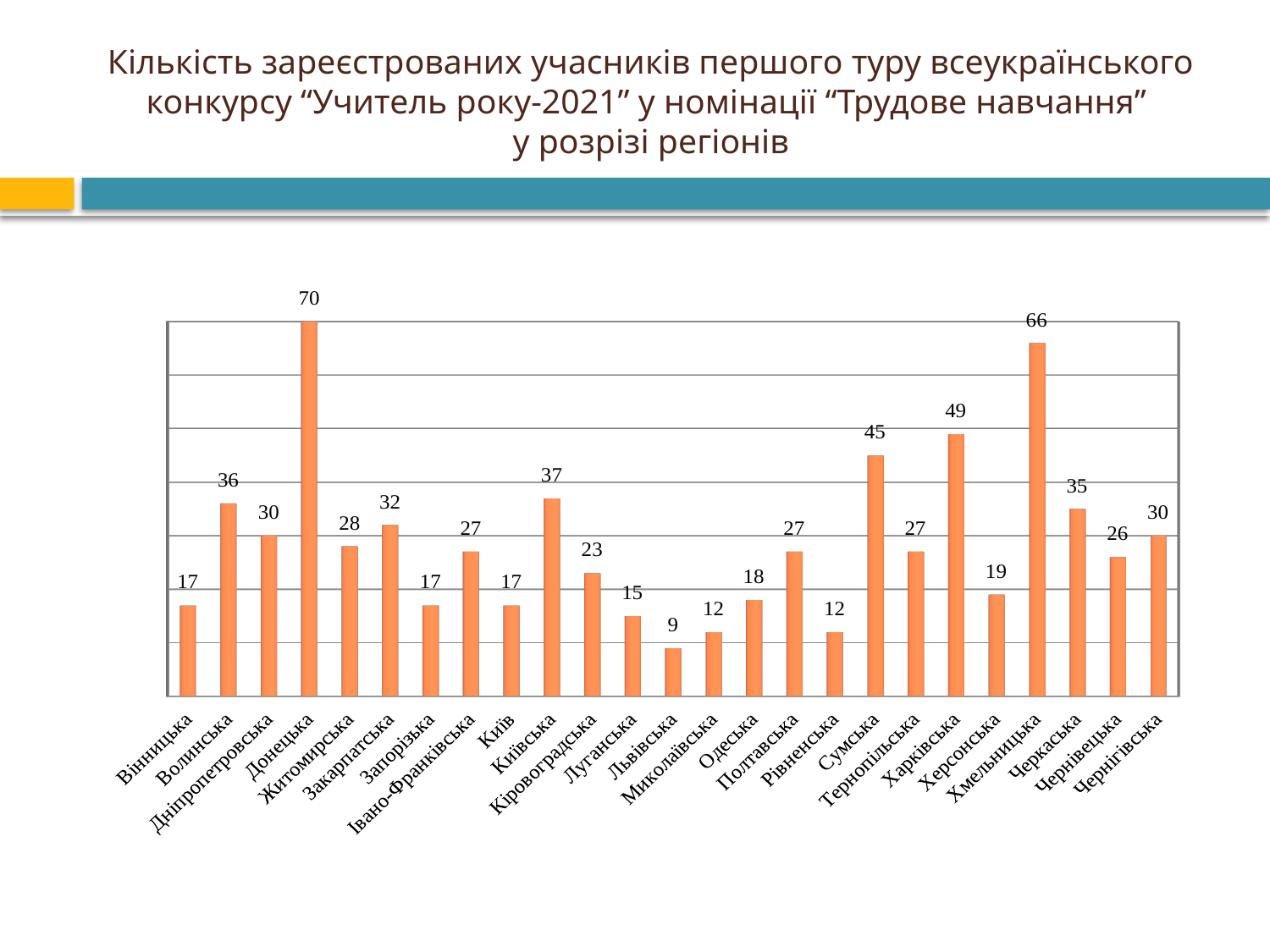
What is the difference between the values for Сумська and Харківська? 4 Which region has the highest value? Донецька Which region has the lowest value? Львівська What is the value for Львівська? 9 What is the value for Хмельницька? 66 How many regions are shown on the chart? 25 What is the value for Харківська? 49 What kind of chart is shown on the slide? Bar chart What is the difference between the values for Донецька and Хмельницька? 4 What is the value for Донецька? 70 Which is larger, the value for Волинська or the value for Київська? Київська Which is larger, the value for Черкаська or the value for Чернівецька? Черкаська